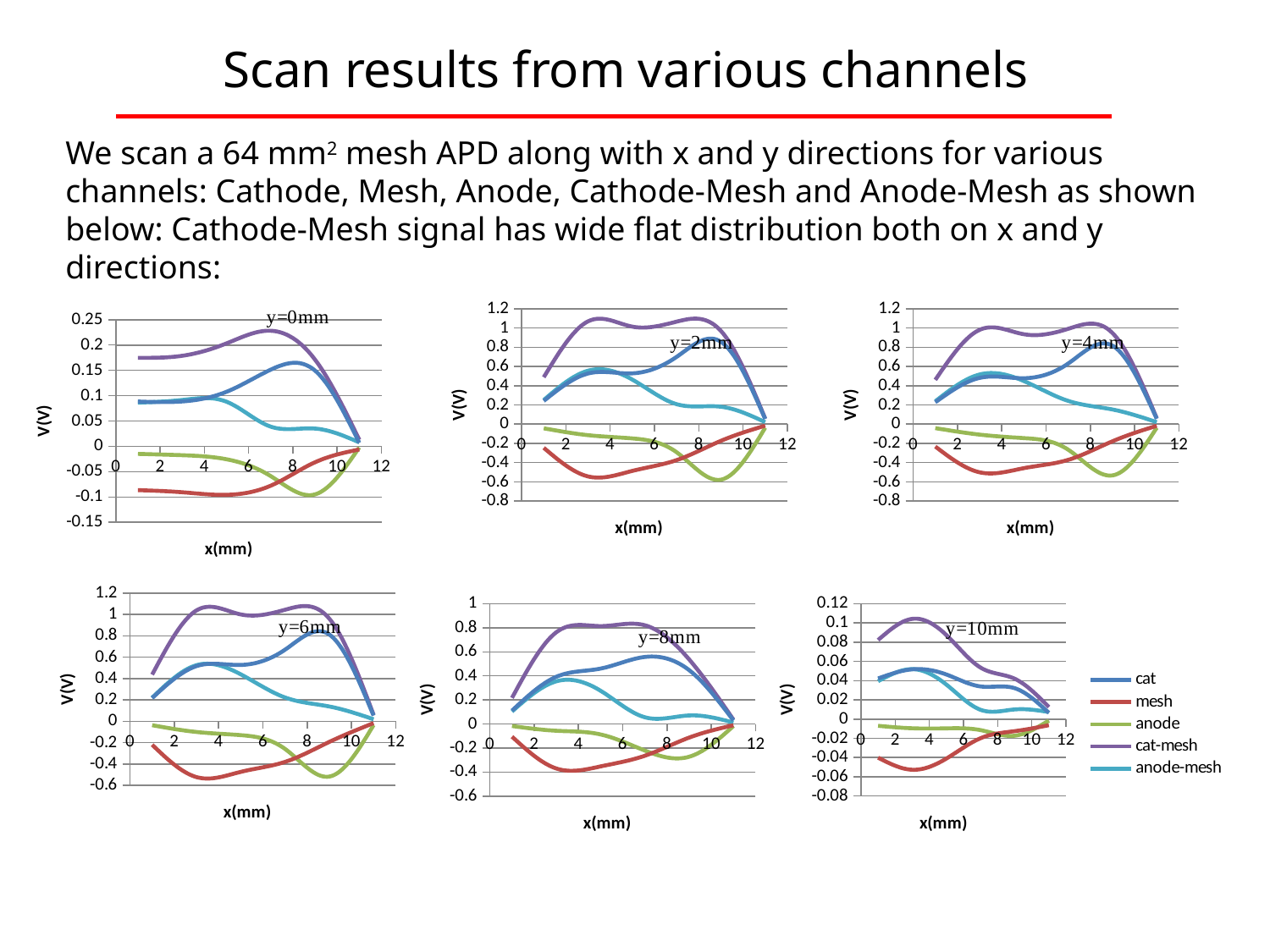
In the y=2mm chart, is the peak value of the cat-mesh series greater or less than 1? greater In the y=0mm chart, is the peak value of the cat-mesh series greater or less than 0.2? greater What is the y-axis label on the y=6mm chart? V(V) In the y=10mm chart, is the lowest value of the mesh series greater or less than -0.04? less What is the x-axis label on the y=4mm chart? x(mm) How many series does the legend on the y=10mm chart list? 5 What kind of chart is the y=0mm chart? line chart How many charts are shown on the slide? 6 In the y=0mm chart, does the cat-mesh series rise or fall between x=8 and x=11? fall In the y=8mm chart, which series reaches the lowest value? mesh In the y=8mm chart, at x=2, which is larger: the cat-mesh value or the cat value? cat-mesh In the y=0mm chart, which series reaches the highest value? cat-mesh